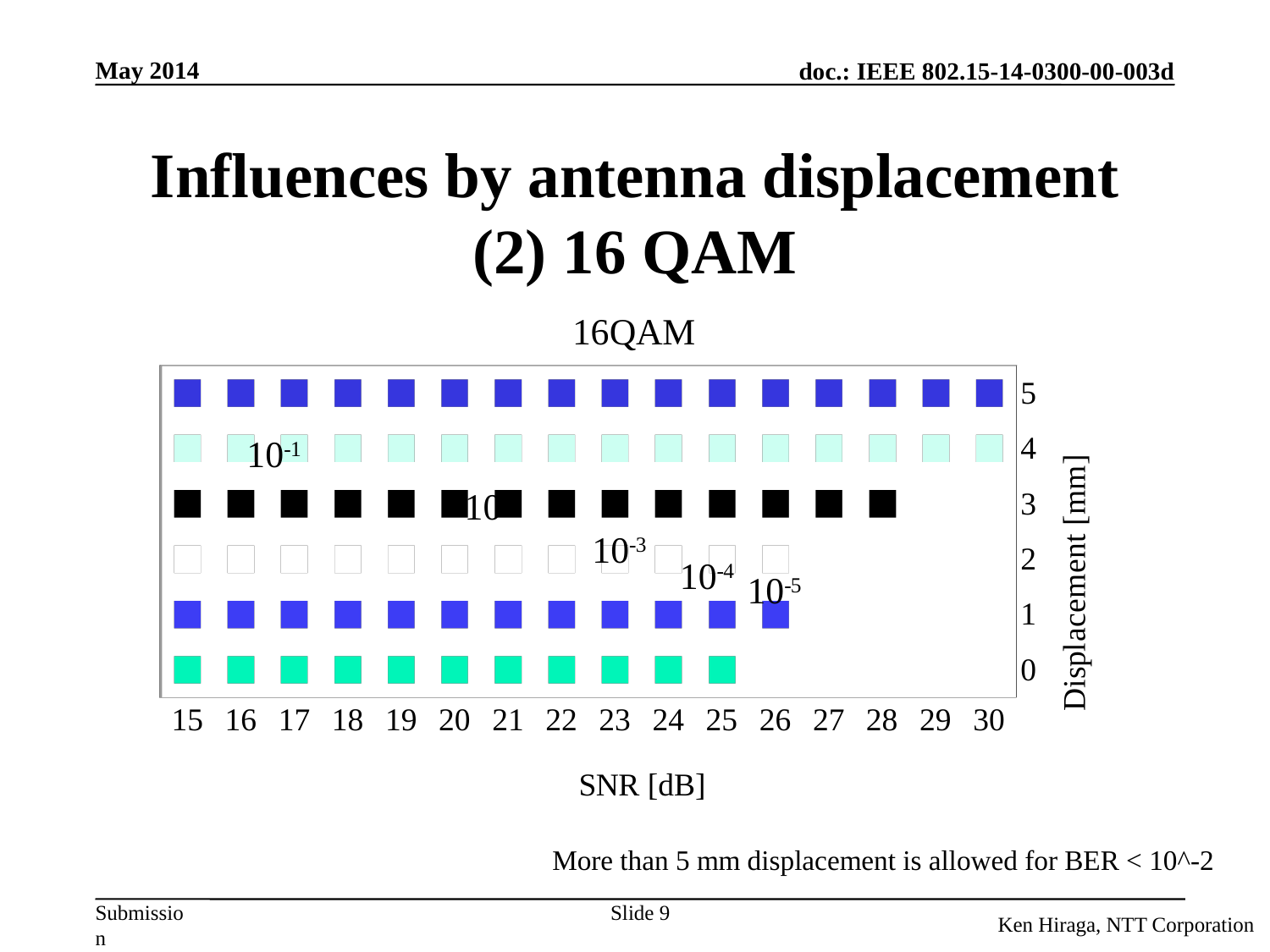
What is the title of the chart? 16QAM What is the highest SNR value at which a marker is plotted for a displacement of 0 mm? 25 Which displacement row has more plotted markers: 5 mm or 0 mm? 5 mm What is the highest SNR value at which a marker is plotted for a displacement of 1 mm? 26 What is the highest SNR value shown on the x axis of the chart? 30 How many SNR values are marked along the x axis of the chart? 16 What is the lowest SNR value shown on the x axis of the chart? 15 What is the highest SNR value at which a marker is plotted for a displacement of 3 mm? 28 What kind of chart is shown on the slide? scatter chart How many markers are plotted in the 0 mm displacement row? 11 What is the label of the x axis of the chart? SNR [dB] How many displacement levels are marked along the y axis of the chart? 6